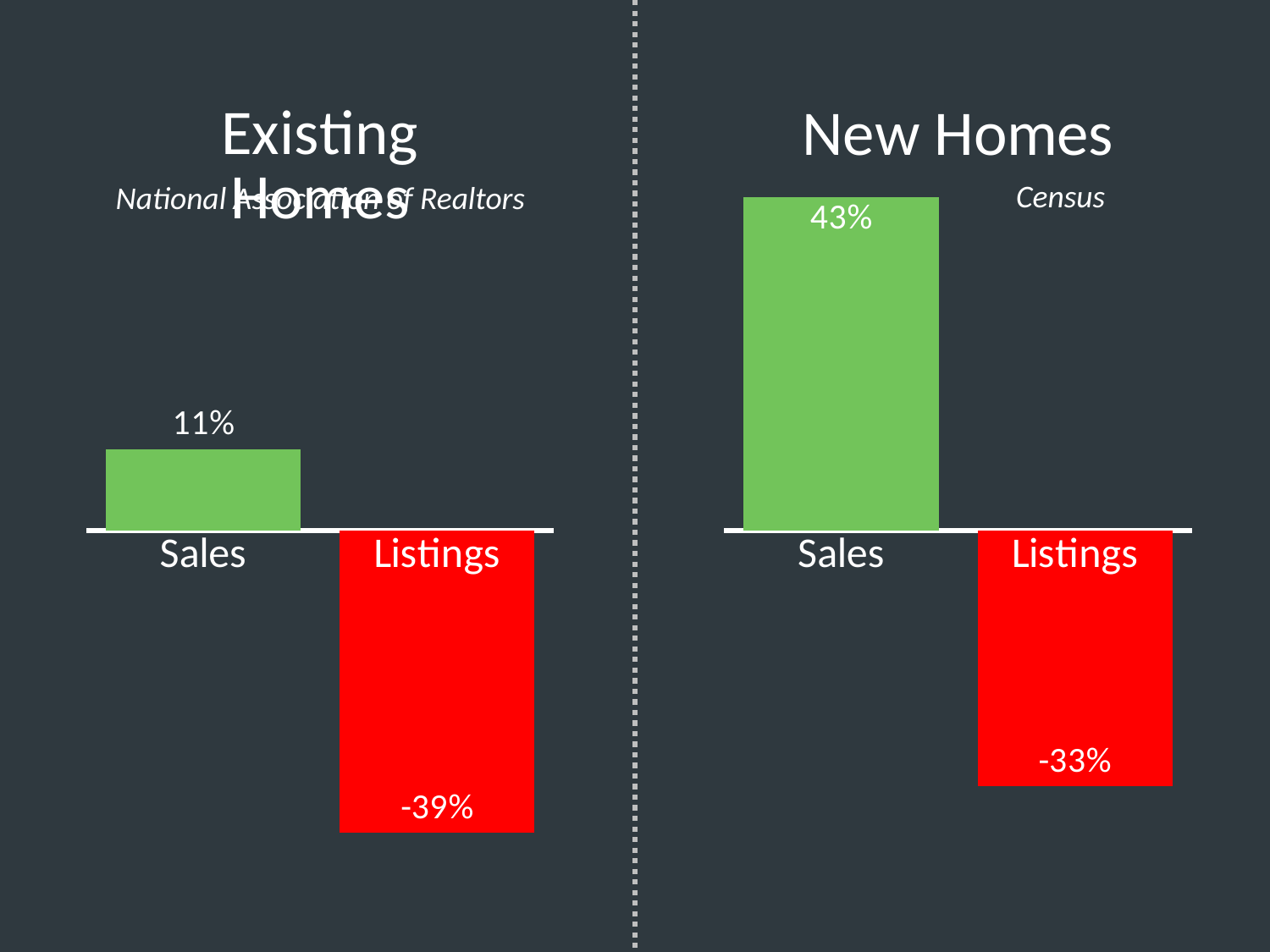
In the New Homes chart, what is the value for Listings? -33% Is the Sales value larger in the Existing Homes chart or the New Homes chart? New Homes In the New Homes chart, what is the difference between the Sales value and the Listings value? 76 percentage points In the Existing Homes chart, what is the value for Sales? 11% What kind of chart is the New Homes chart? Bar chart In the New Homes chart, which category has the lowest value? Listings In the Existing Homes chart, which category has the highest value? Sales In the Existing Homes chart, what is the difference between the Sales value and the Listings value? 50 percentage points In the New Homes chart, what is the value for Sales? 43% What colour is the Listings bar in the New Homes chart? Red In the Existing Homes chart, what is the value for Listings? -39% How many categories are shown in the Existing Homes chart? 2